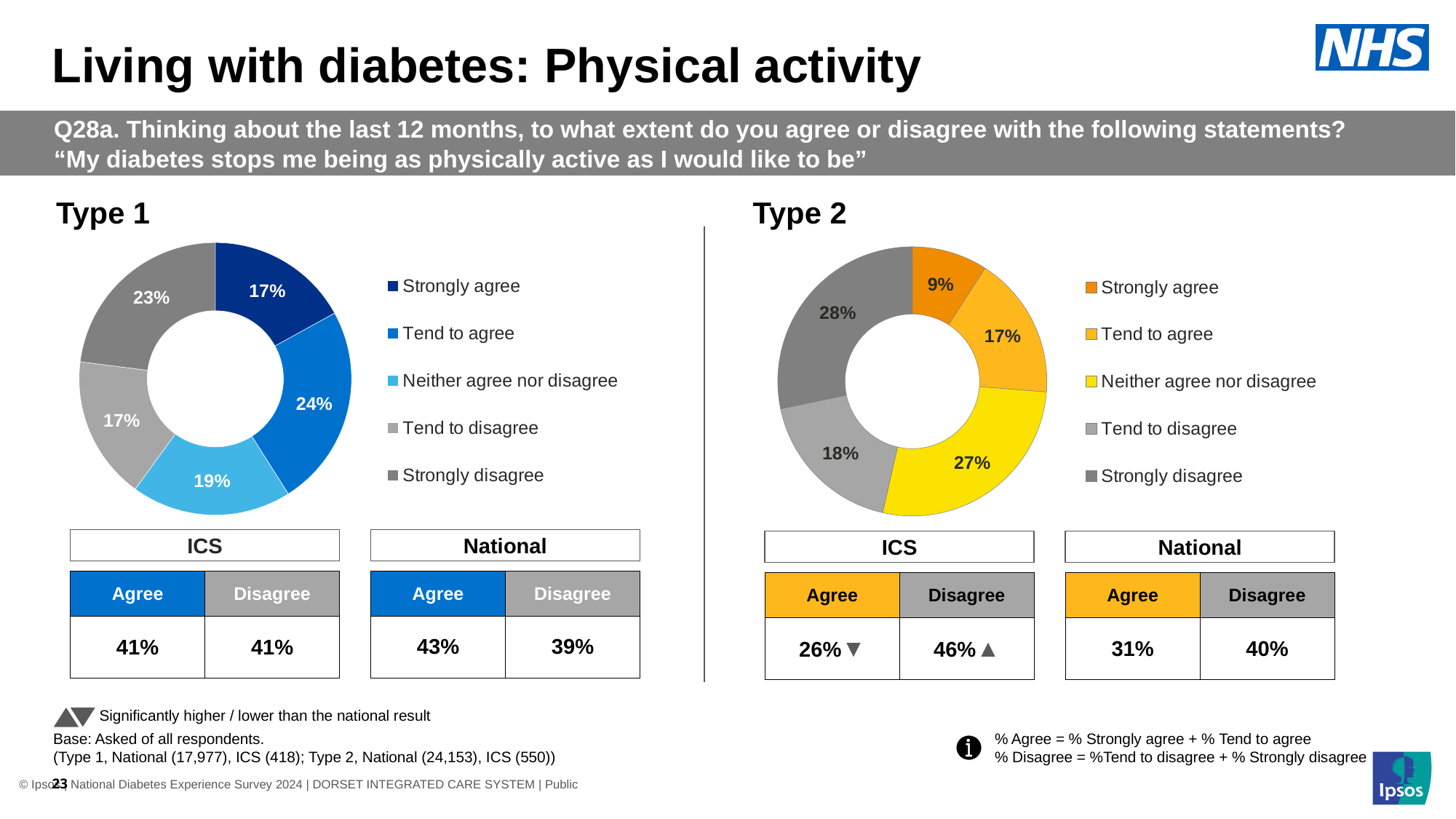
How many categories does the legend of the Type 1 chart list? 5 In the Type 2 chart, what is the difference between the Strongly disagree and Strongly agree shares? 19% In the Type 2 chart, which is larger: Tend to disagree or Neither agree nor disagree? Neither agree nor disagree In the Type 1 chart, which category has the largest share? Tend to agree In the Type 1 chart, what is the difference between the Tend to agree and Neither agree nor disagree shares? 5% In the Type 2 chart, what percentage is shown for Neither agree nor disagree? 27% In the Type 1 chart, what percentage is shown for Tend to agree? 24% In the Type 2 chart, what percentage is shown for Strongly agree? 9% In the Type 1 chart, what percentage is shown for Strongly disagree? 23% What kind of chart is used for Type 2? Donut (pie) chart In the Type 2 chart, which category has the smallest share? Strongly agree In the Type 2 chart, which category has the largest share? Strongly disagree